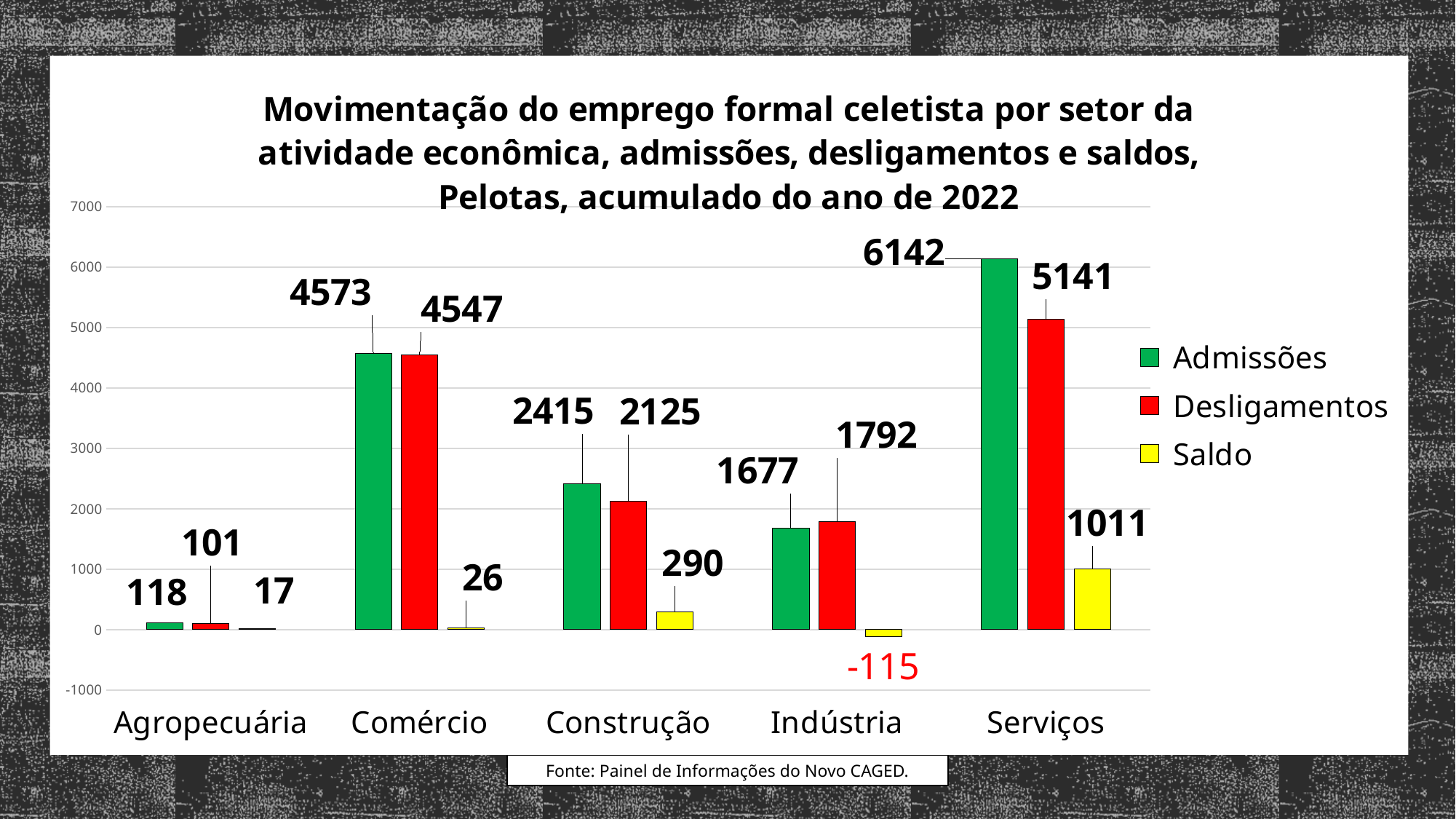
How many sectors are shown on the x axis? 5 Which colour represents the Saldo series in the legend? Yellow How many series does the legend list? 3 What kind of chart is shown on the slide? Bar chart Is the Desligamentos value for Serviços greater or less than 5000? greater What is the Saldo value for Indústria? -115 Which is larger for Indústria, Admissões or Desligamentos? Desligamentos What is the Desligamentos value for Comércio? 4547 Which sector has the lowest Saldo value? Indústria What is the difference between Admissões and Desligamentos for Construção? 290 Which sector has the highest Admissões value? Serviços What is the Admissões value for Serviços? 6142